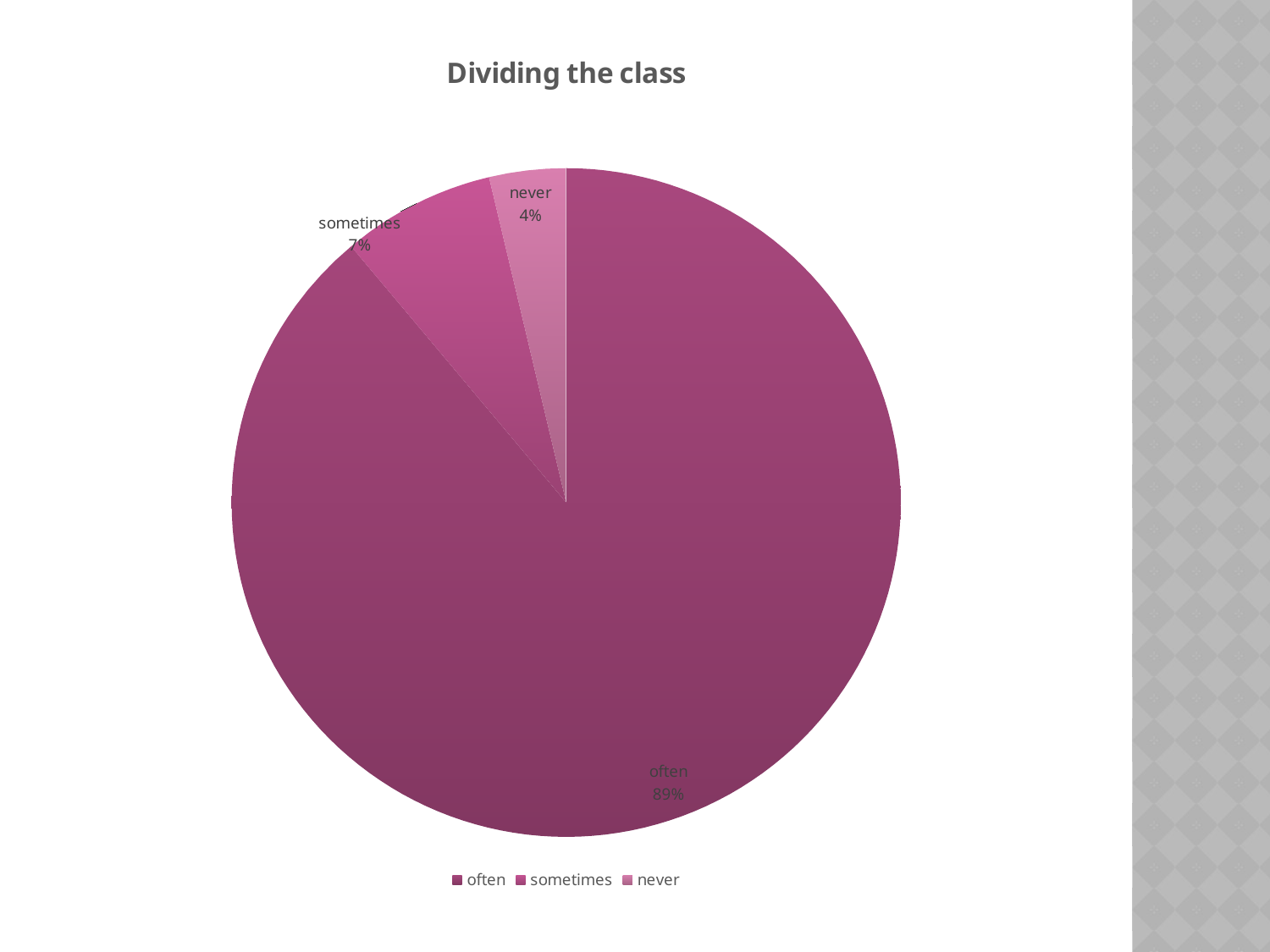
What share of the pie does the 'often' slice represent? 89% How many entries does the legend list? 3 What kind of chart is shown on the slide? pie chart How many slices does the pie chart have? 3 What is the title of the chart? Dividing the class Which category has the largest slice of the pie? often What is the difference in percentage points between the 'often' and 'sometimes' slices? 82 What is the difference in percentage points between the 'sometimes' and 'never' slices? 3 Which category has the smallest slice of the pie? never Which slice is larger, 'sometimes' or 'never'? sometimes What share of the pie does the 'sometimes' slice represent? 7% What share of the pie does the 'never' slice represent? 4%